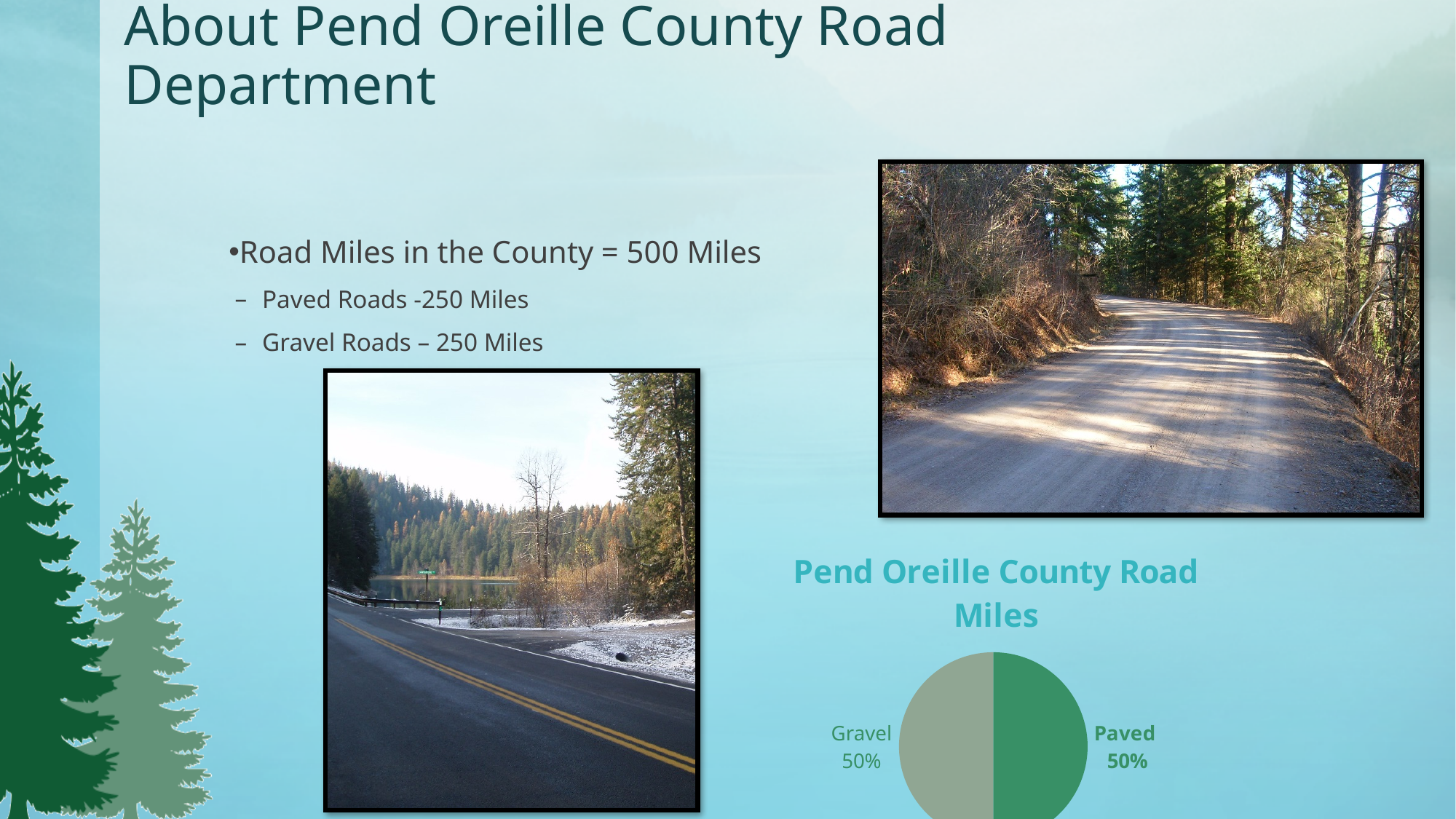
What kind of chart is shown on the slide? pie chart What share of the pie does the Paved slice represent? 50% What is the title of the chart? Pend Oreille County Road Miles How many slices does the pie chart have? 2 What are the two categories shown in the pie chart? Gravel and Paved What is the combined share of the Gravel and Paved slices? 100% What is the difference between the Paved and Gravel shares in the pie chart? 0% What share of the pie does the Gravel slice represent? 50%